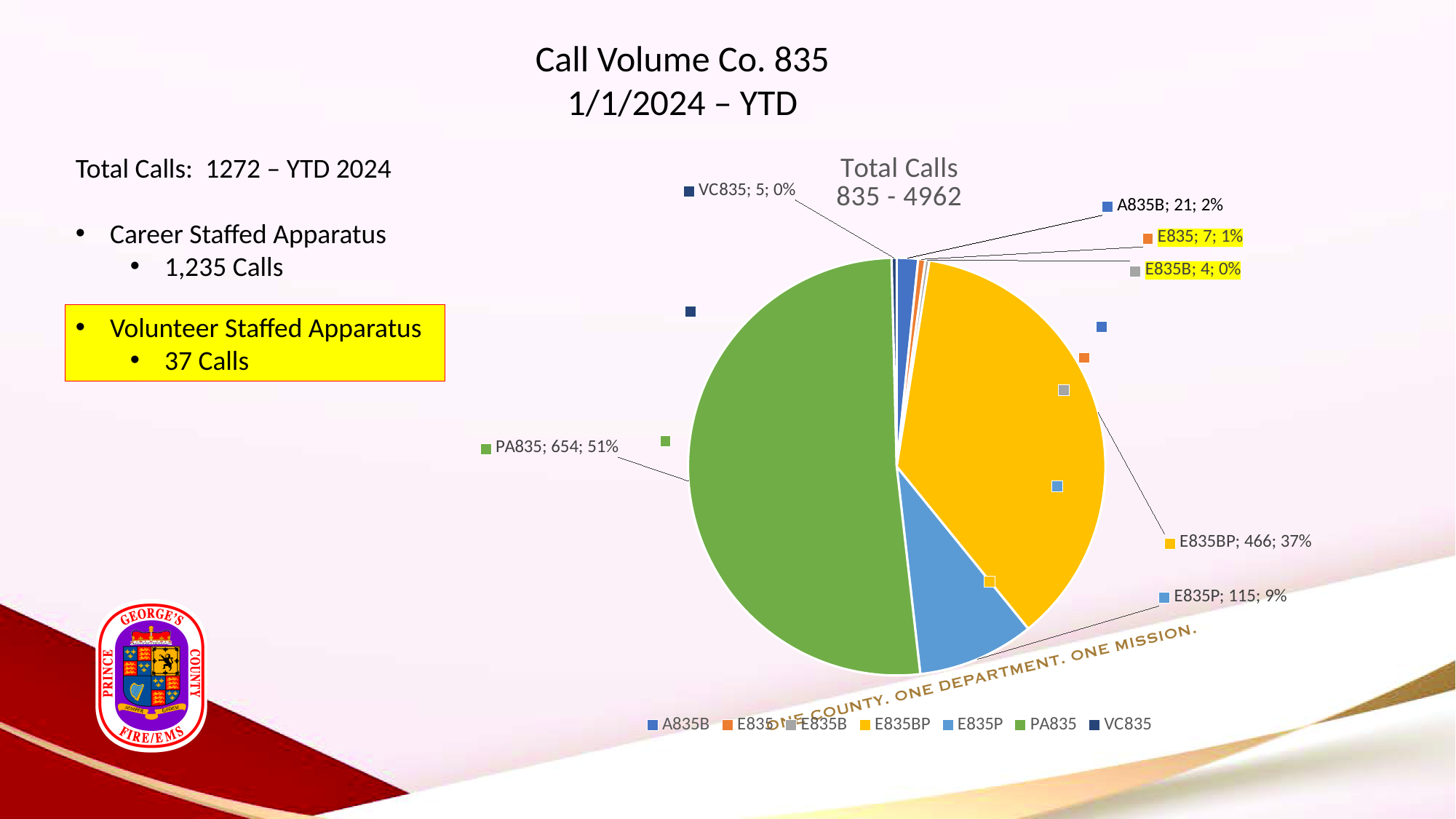
Which category has the smallest slice of the pie chart? E835B How many slices does the pie chart have? 7 What share of the pie does E835BP represent? 37% What is the value for A835B in the pie chart? 21 How many entries does the chart legend list? 7 What is the difference between the values for PA835 and E835BP? 188 What type of chart is shown on the slide? pie chart What is the title of the chart? Total Calls 835 - 4962 What is the value for E835P in the pie chart? 115 What is the value for E835BP in the pie chart? 466 What is the value for PA835 in the pie chart? 654 Which category has the largest slice of the pie chart? PA835